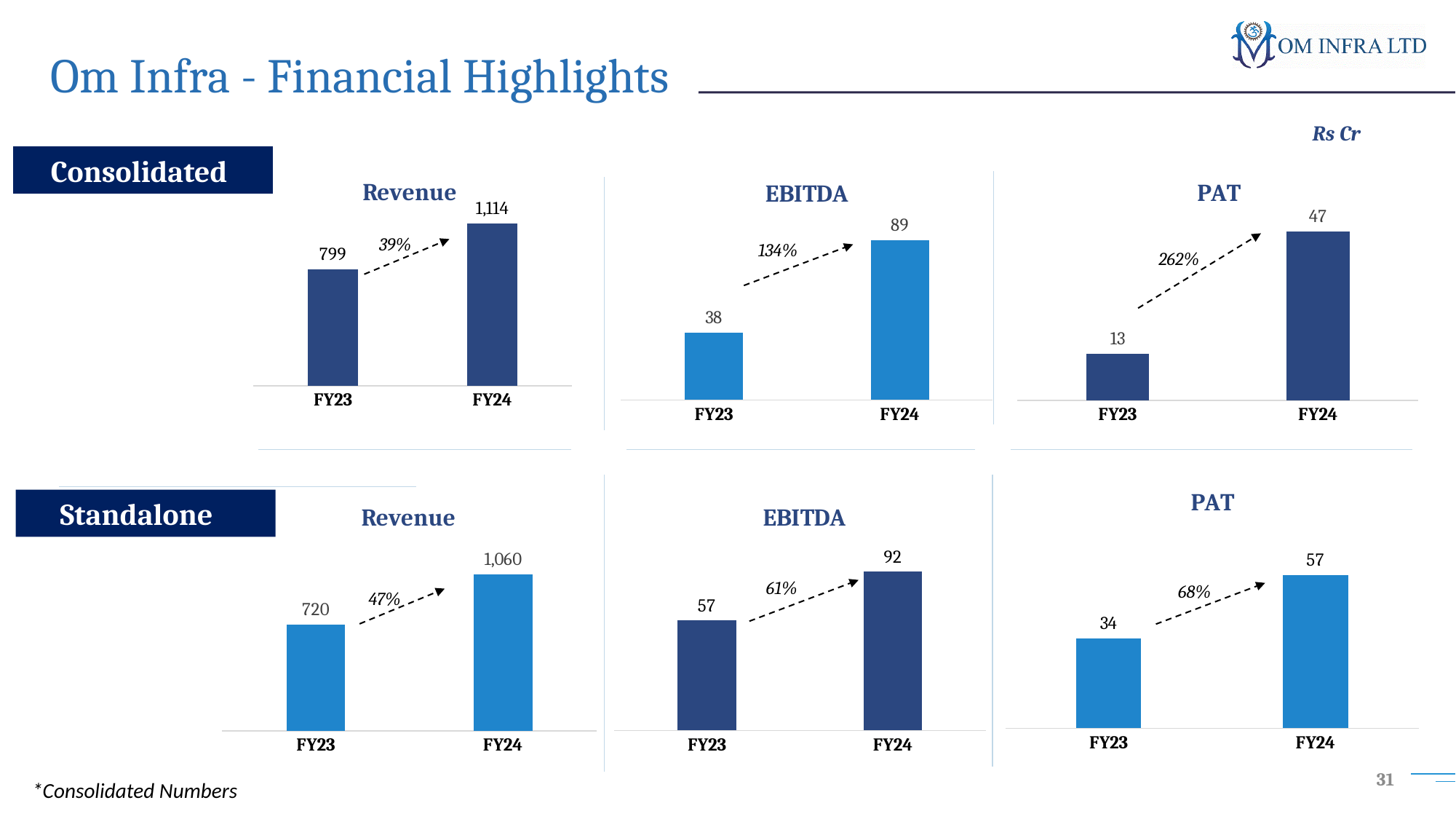
In the Standalone Revenue chart, what is the value for FY23? 720 In the Standalone PAT chart, what is the value for FY23? 34 In the Consolidated PAT chart, what is the value for FY24? 47 In the Consolidated PAT chart, what is the difference between the FY24 and FY23 values? 34 In the Consolidated Revenue chart, what is the difference between the FY24 and FY23 values? 315 In the Standalone EBITDA chart, which year has the higher value, FY23 or FY24? FY24 In the Consolidated PAT chart, what percentage growth is shown on the arrow between FY23 and FY24? 262% In the Consolidated EBITDA chart, which year has the lowest value? FY23 What kind of chart is the Standalone PAT chart? Bar chart In the Consolidated EBITDA chart, what is the value for FY23? 38 In the Consolidated Revenue chart, what is the value for FY24? 1,114 In the Standalone EBITDA chart, what is the value for FY24? 92